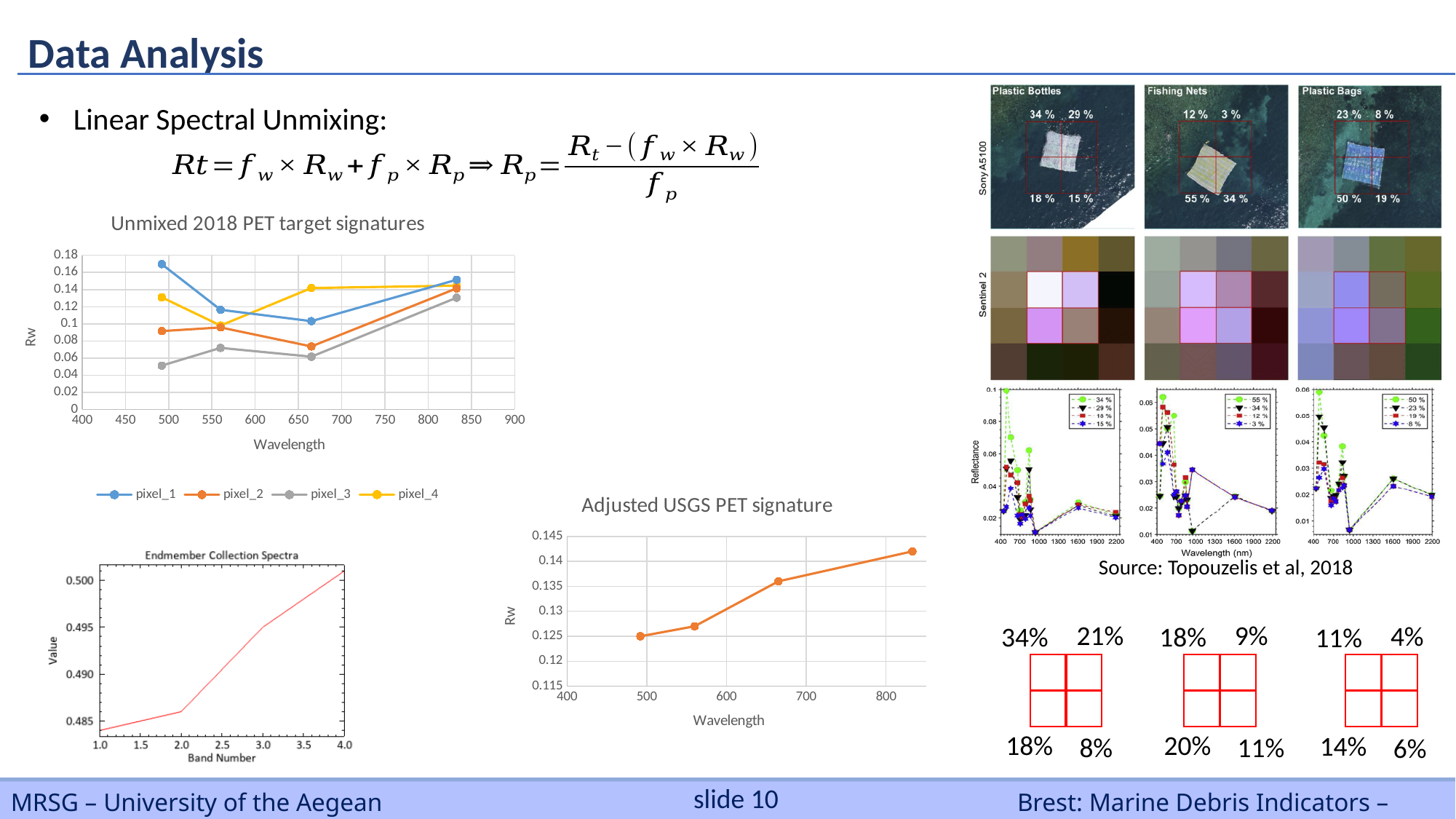
What kind of chart is the 'Unmixed 2018 PET target signatures' chart? line chart In the 'Unmixed 2018 PET target signatures' chart, which series has the highest value at the first wavelength (around 490)? pixel_1 In the 'Adjusted USGS PET signature' chart, do the values rise or fall as wavelength increases? rise How many data points are plotted in the 'Adjusted USGS PET signature' chart? 4 In the 'Unmixed 2018 PET target signatures' chart, is the value of pixel_3 at the first wavelength (around 490) greater or less than 0.06? less In the 'Unmixed 2018 PET target signatures' chart, which is larger at the wavelength around 665: pixel_4 or pixel_2? pixel_4 In the 'Endmember Collection Spectra' chart, do the values rise or fall as the band number increases? rise How many series does the legend of the 'Unmixed 2018 PET target signatures' chart list? 4 In the 'Adjusted USGS PET signature' chart, is the value at the last wavelength (around 830) greater or less than 0.14? greater In the 'Unmixed 2018 PET target signatures' chart, which series has the lowest value at the first wavelength (around 490)? pixel_3 In the 'Unmixed 2018 PET target signatures' chart, is the value of pixel_1 at the first wavelength (around 490) greater or less than 0.16? greater What is the y-axis label of the 'Unmixed 2018 PET target signatures' chart? Rw